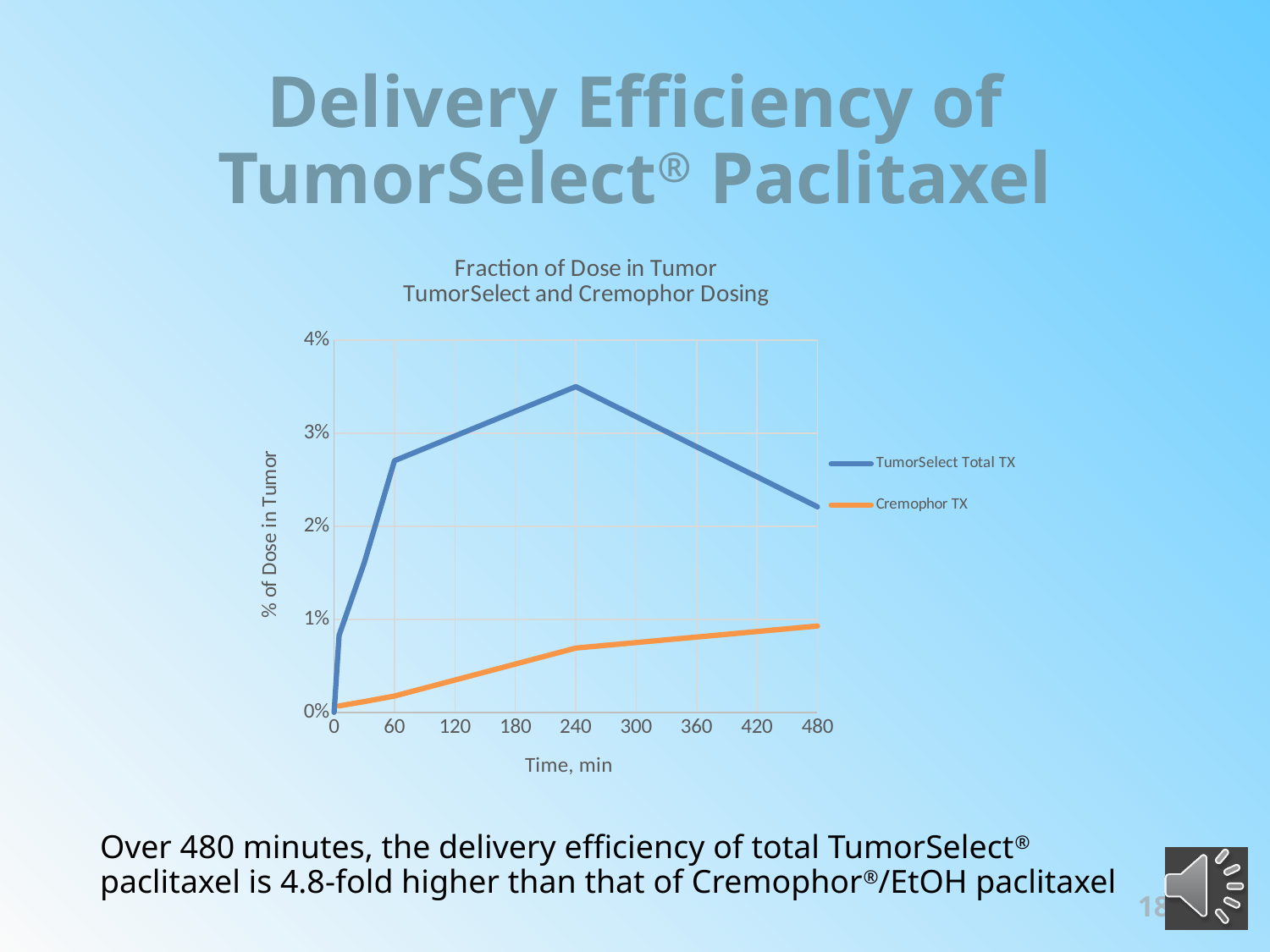
Is the value for TumorSelect Total TX at 480 min greater or less than 2%? greater At 480 min, which series has the larger value, TumorSelect Total TX or Cremophor TX? TumorSelect Total TX Is the value for Cremophor TX at 480 min greater or less than 1%? less What is the label of the y axis? % of Dose in Tumor What is the label of the x axis? Time, min At which time (in minutes) does the TumorSelect Total TX series reach its highest value? 240 What kind of chart is shown on the slide? line chart Is the value for TumorSelect Total TX at 60 min greater or less than 2%? greater Does the Cremophor TX series rise or fall from 0 to 480 min? rise How many series does the legend list? 2